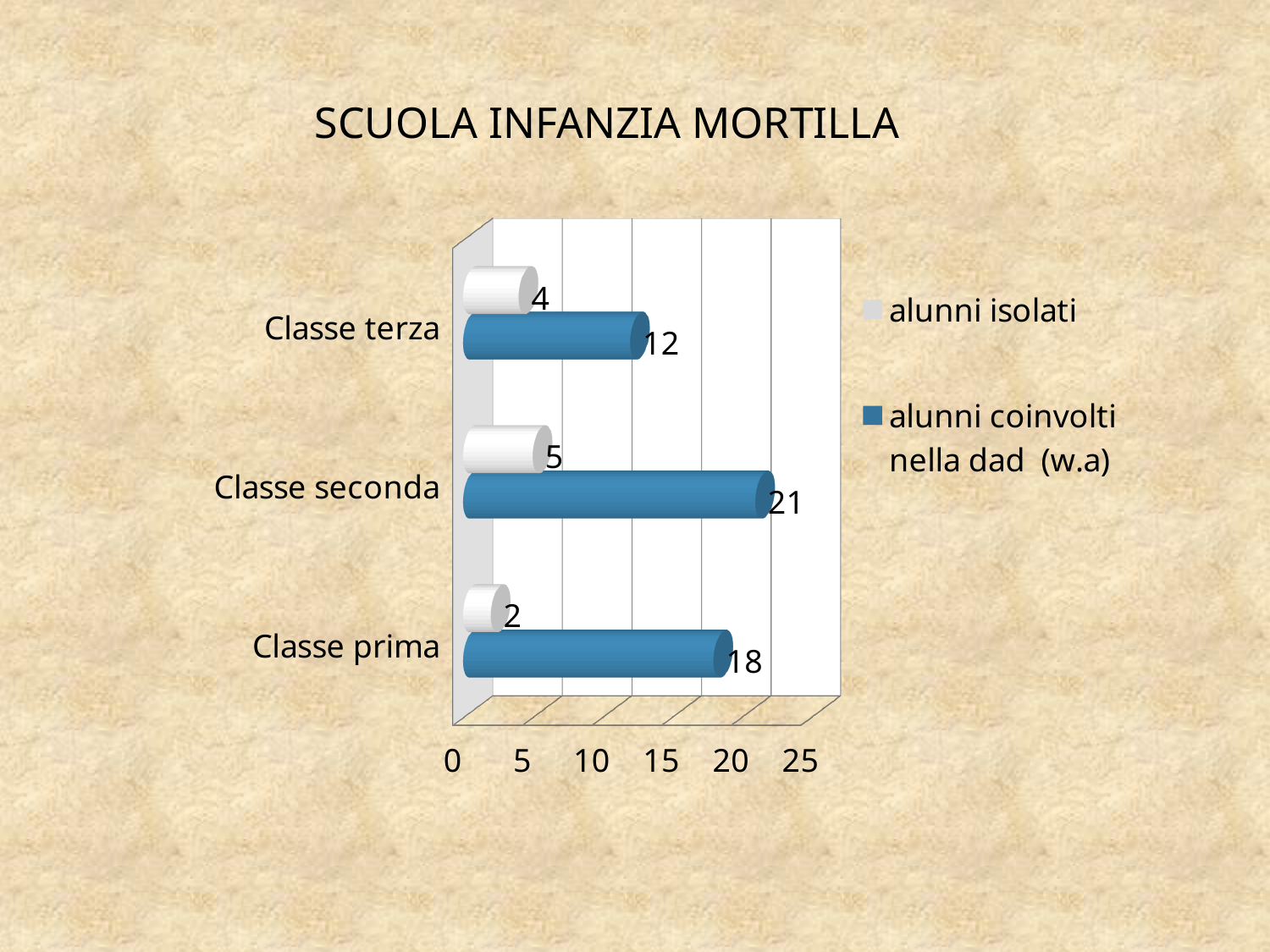
Which class has the lowest value for 'alunni isolati'? Classe prima How many classes are shown on the chart? 3 What is the value of 'alunni coinvolti nella dad (w.a)' for Classe prima? 18 Which is larger: 'alunni isolati' for Classe seconda or for Classe terza? Classe seconda Which class has the highest value for 'alunni coinvolti nella dad (w.a)'? Classe seconda What is the value of 'alunni coinvolti nella dad (w.a)' for Classe seconda? 21 What is the value of 'alunni isolati' for Classe prima? 2 What is the value of 'alunni isolati' for Classe terza? 4 What is the title of the chart? SCUOLA INFANZIA MORTILLA What kind of chart is shown on the slide? Bar chart How many series does the legend list? 2 What is the difference between 'alunni coinvolti nella dad (w.a)' for Classe seconda and Classe terza? 9